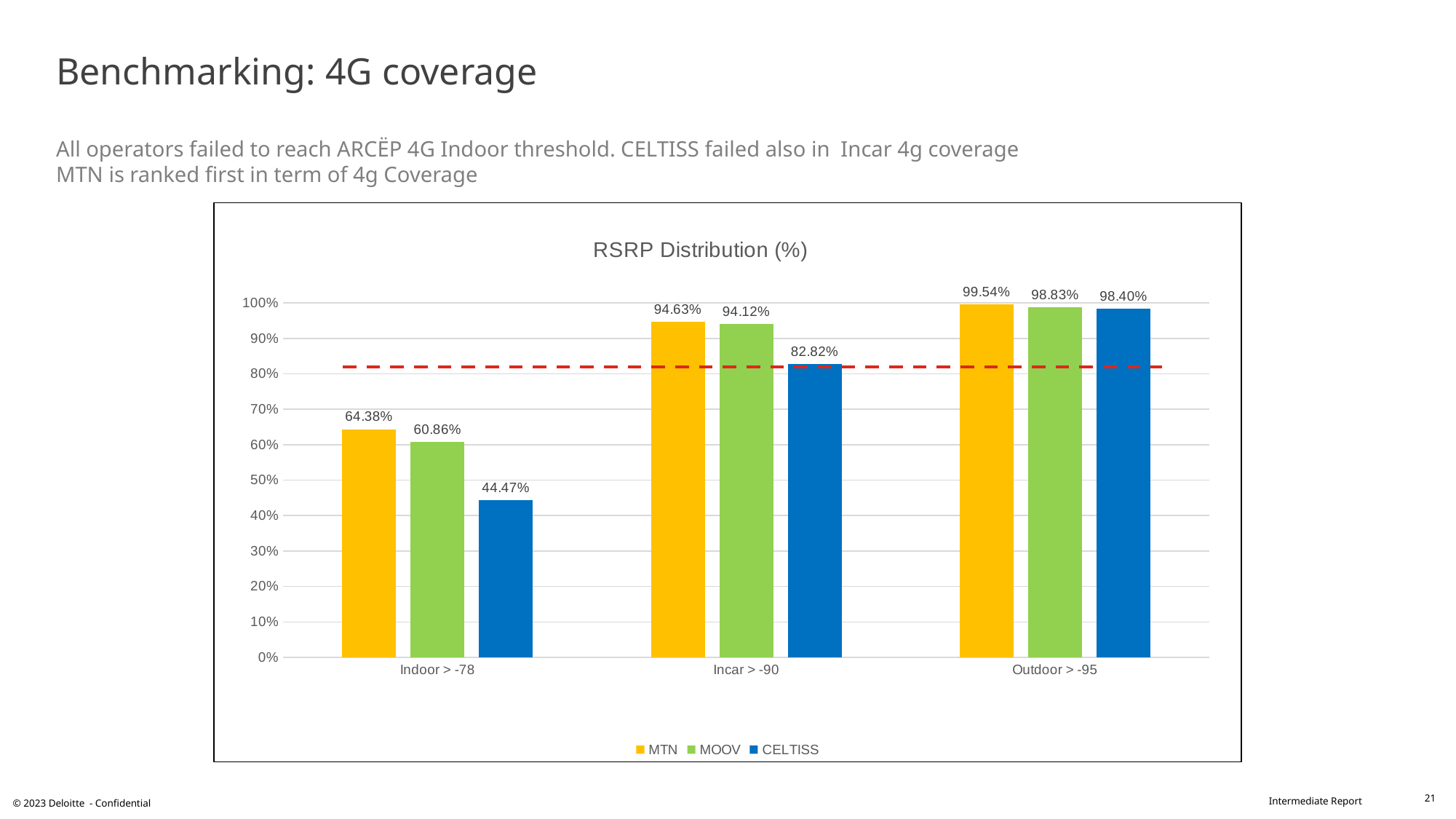
Which operator has the lowest value in the Indoor > -78 category? CELTISS What is the difference between MTN and CELTISS in the Indoor > -78 category? 19.91% What is the value for CELTISS in the Incar > -90 category? 82.82% What is the value for MOOV in the Outdoor > -95 category? 98.83% Which operator has the highest value in the Outdoor > -95 category? MTN How many categories are shown on the x axis? 3 Is the value for CELTISS in the Indoor > -78 category greater or less than 50%? less What is the value for MTN in the Indoor > -78 category? 64.38% How many series does the legend list? 3 What type of chart is shown on the slide? Bar chart Which is larger: MTN in Incar > -90 or MOOV in Incar > -90? MTN in Incar > -90 What is the difference between MOOV and CELTISS in the Incar > -90 category? 11.30%